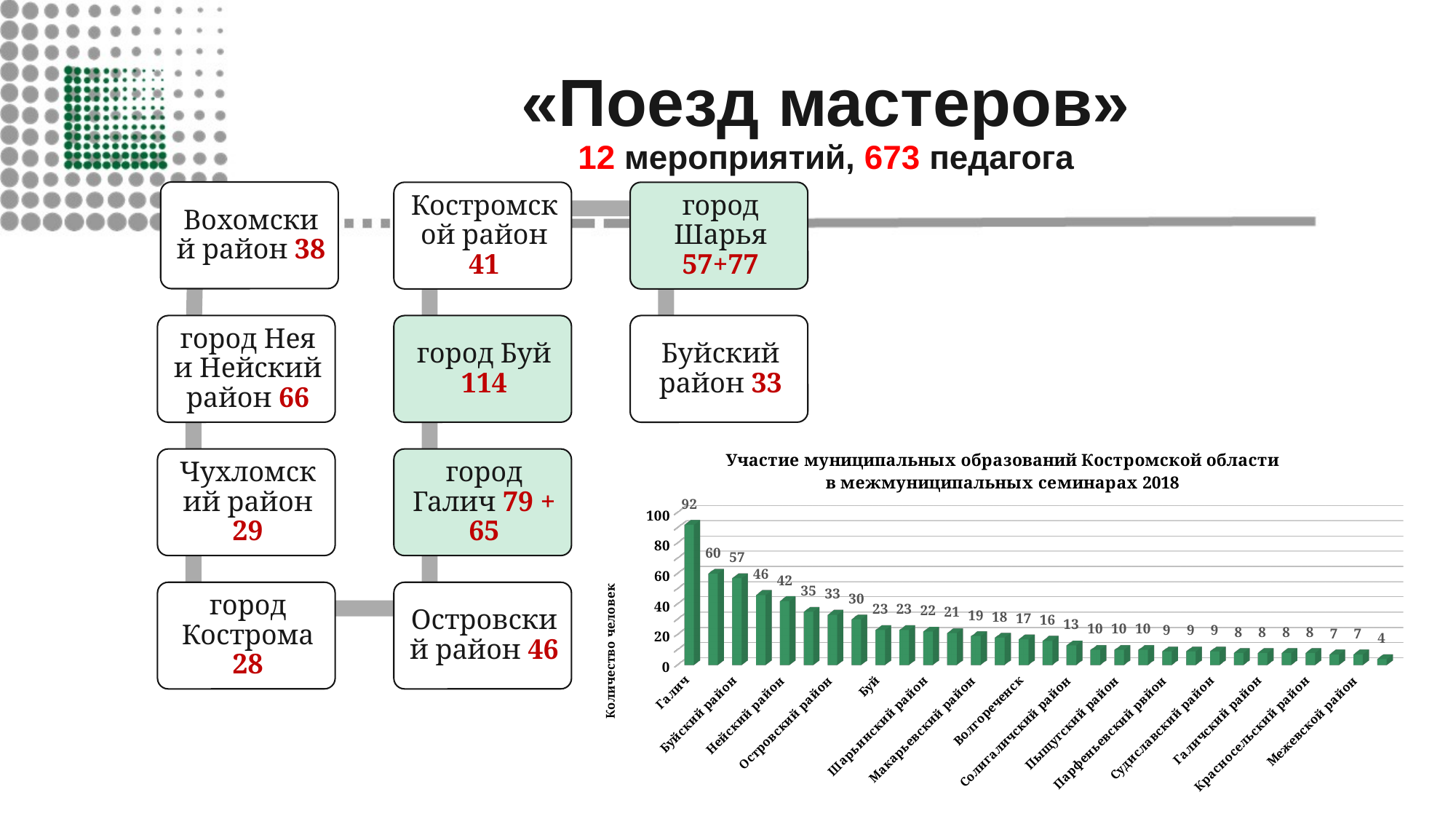
How many bars are plotted in the chart? 30 What is the lowest value shown in the chart? 4 Which category has the highest value in the chart? Галич What is the difference between the highest and lowest values in the chart? 88 Is the value for Галич greater or less than 80? greater What is the highest value shown in the chart? 92 What kind of chart is shown on the slide? bar chart What is the label of the vertical axis of the chart? Количество человек Do the values rise or fall from left to right along the x axis? fall What is the title of the chart? Участие муниципальных образований Костромской области в межмуниципальных семинарах 2018 What is the second-highest value shown in the chart? 60 What is the value for Галич in the chart? 92